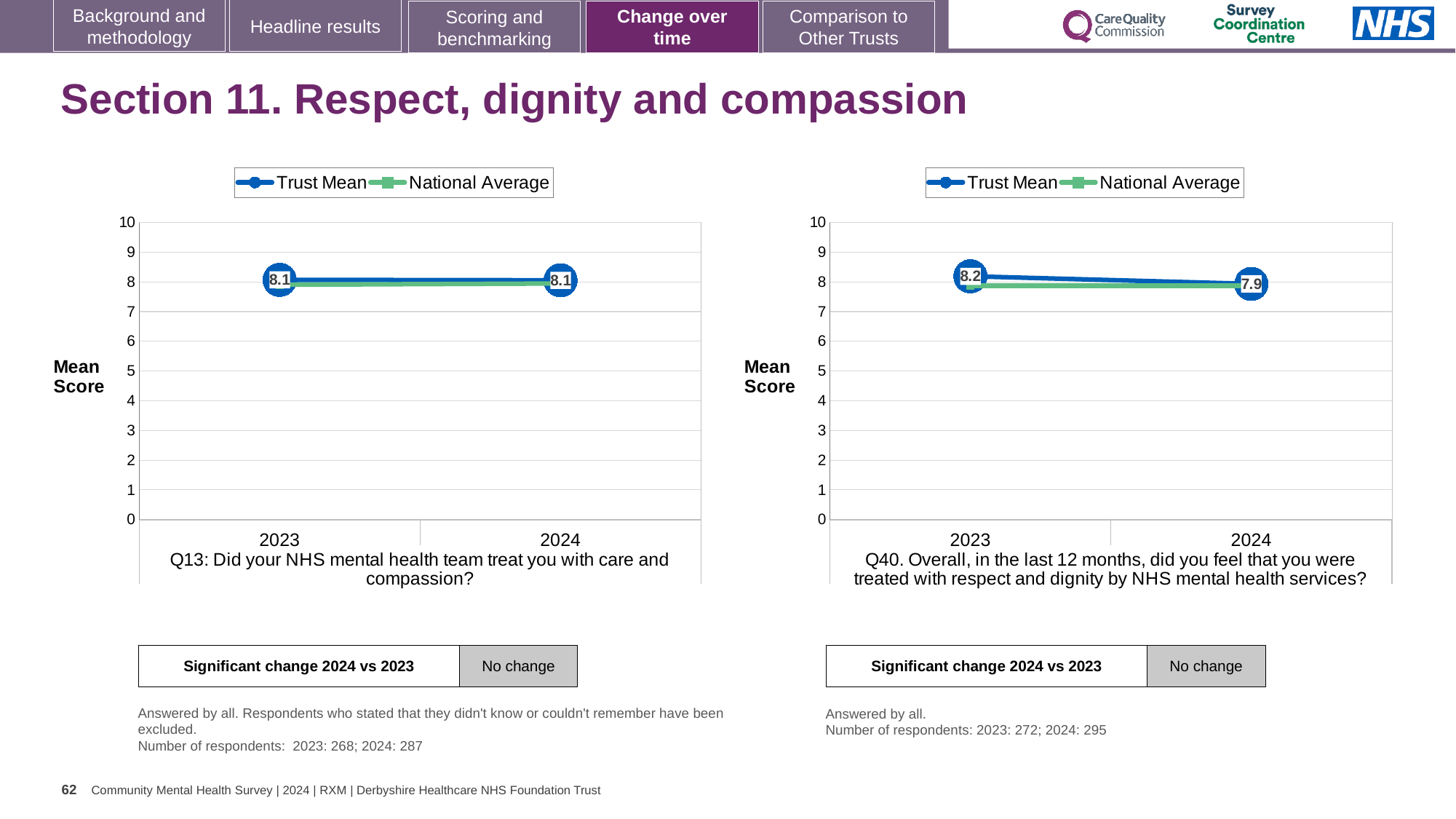
In the left chart (Q13), what is the Trust Mean for 2023? 8.1 In the right chart (Q40), does the Trust Mean rise or fall from 2023 to 2024? fall How many years are plotted on the x axis of the left chart (Q13)? 2 What are the two series named in the legend of the left chart (Q13)? Trust Mean and National Average In the right chart (Q40), what is the Trust Mean for 2023? 8.2 In the left chart (Q13), is the National Average for 2024 greater or less than 5? greater In the right chart (Q40), by how much did the Trust Mean change from 2023 to 2024? 0.3 What kind of chart is the left chart (Q13)? line chart How many series does the legend of the right chart (Q40) list? 2 In the left chart (Q13), what is the Trust Mean for 2024? 8.1 In the right chart (Q40), which year has the higher Trust Mean, 2023 or 2024? 2023 In the right chart (Q40), what is the Trust Mean for 2024? 7.9